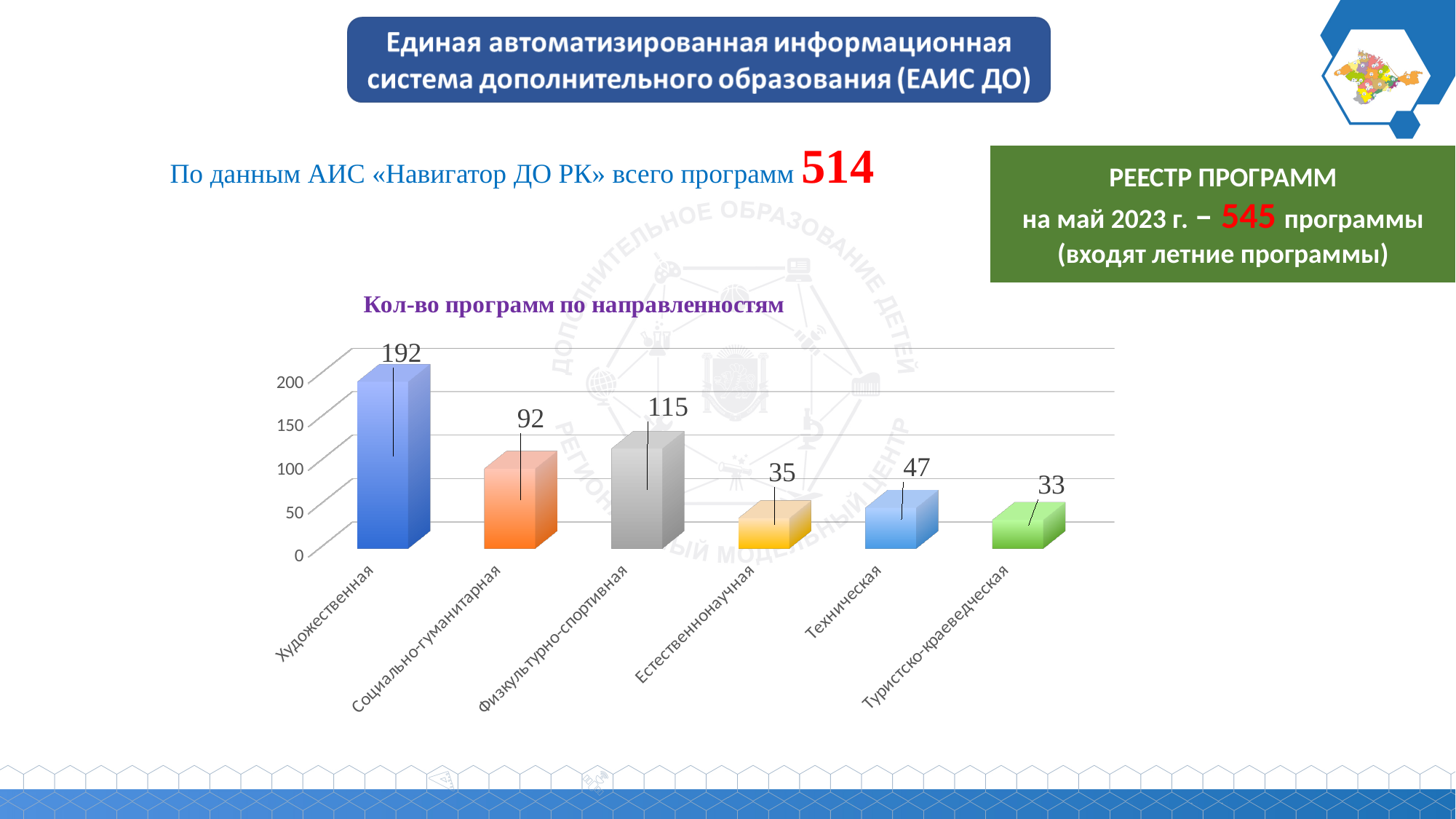
What kind of chart is shown on the slide? bar chart What is the title of the chart? Кол-во программ по направленностям Is the value for Социально-гуманитарная greater or less than 100? less Which category has the lowest value? Туристско-краеведческая What is the value for Физкультурно-спортивная? 115 What is the value for Художественная? 192 Which category has the highest value? Художественная How many categories are shown in the chart? 6 What is the difference between the values for Физкультурно-спортивная and Техническая? 68 What is the value for Туристско-краеведческая? 33 What is the difference between the values for Художественная and Социально-гуманитарная? 100 Which is larger, the value for Техническая or the value for Естественнонаучная? Техническая